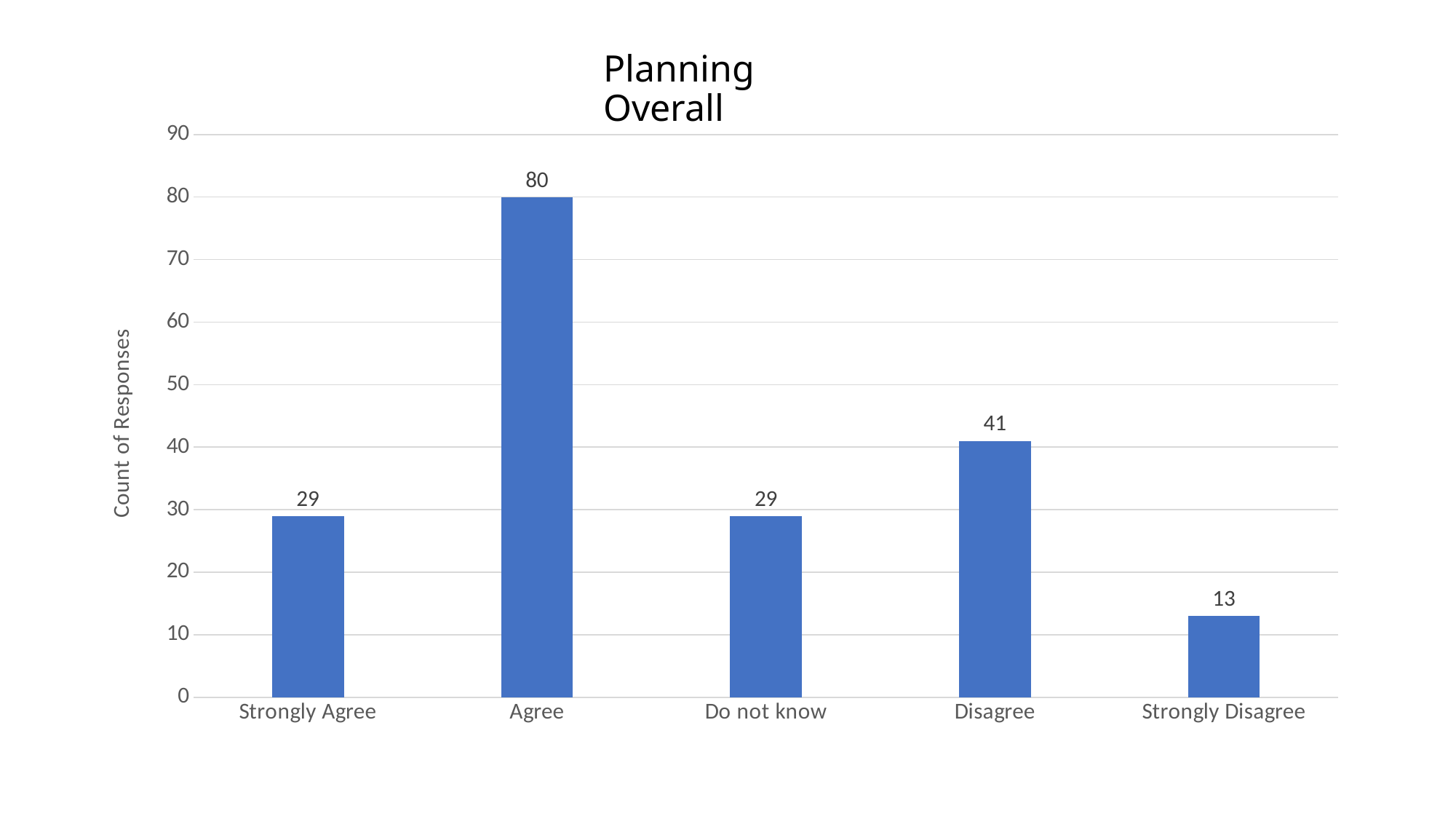
How many categories are shown on the x axis? 5 What is the label of the vertical axis? Count of Responses Which category has the lowest count of responses? Strongly Disagree Which category has the highest count of responses? Agree What is the count of responses for Agree? 80 What is the difference between the counts for Strongly Agree and Strongly Disagree? 16 What kind of chart is shown on the slide? Bar chart What is the difference between the counts for Agree and Disagree? 39 Is the value for Agree greater or less than 70? greater What is the count of responses for Disagree? 41 Which has a larger count of responses, Disagree or Do not know? Disagree What is the count of responses for Strongly Disagree? 13